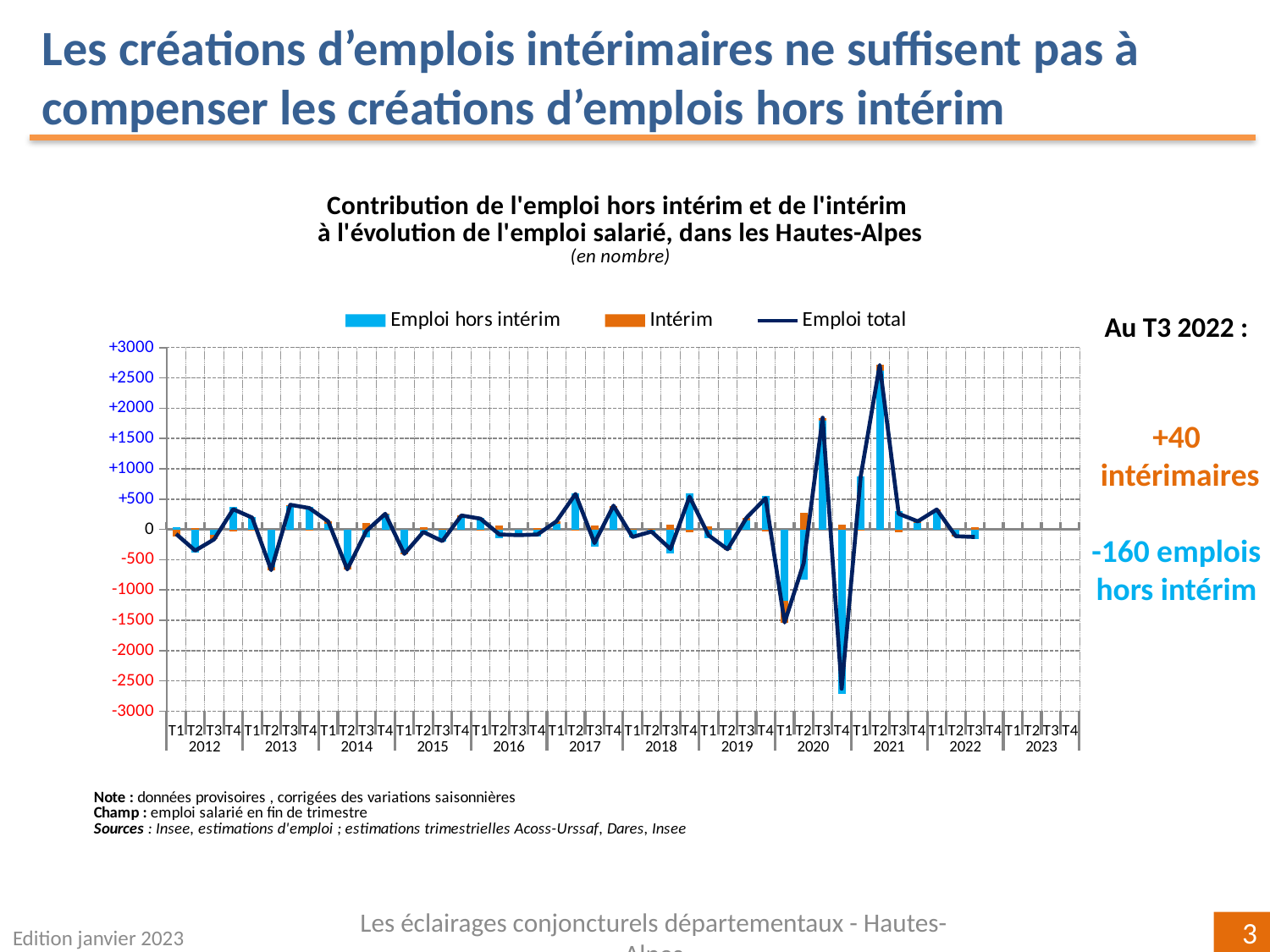
How many series does the chart legend list? 3 In which quarter does the Emploi total line reach its highest value? T2 2021 Which is larger, the Emploi total value at T2 2021 or at T3 2020? T2 2021 Is the Emploi total value at T1 2020 greater or less than -1000? less Is the Emploi total value at T4 2020 greater or less than -2500? less What kind of chart is shown on the slide? A bar chart combined with a line According to the annotation, what is the value for intérimaires at T3 2022? +40 What is the unit indicated under the chart title? en nombre According to the annotation, what is the value for emplois hors intérim at T3 2022? -160 In which quarter does the Emploi total line reach its lowest value? T4 2020 Which colour represents the Intérim series in the chart? Orange Is the Emploi total value at T2 2021 greater or less than +2500? greater